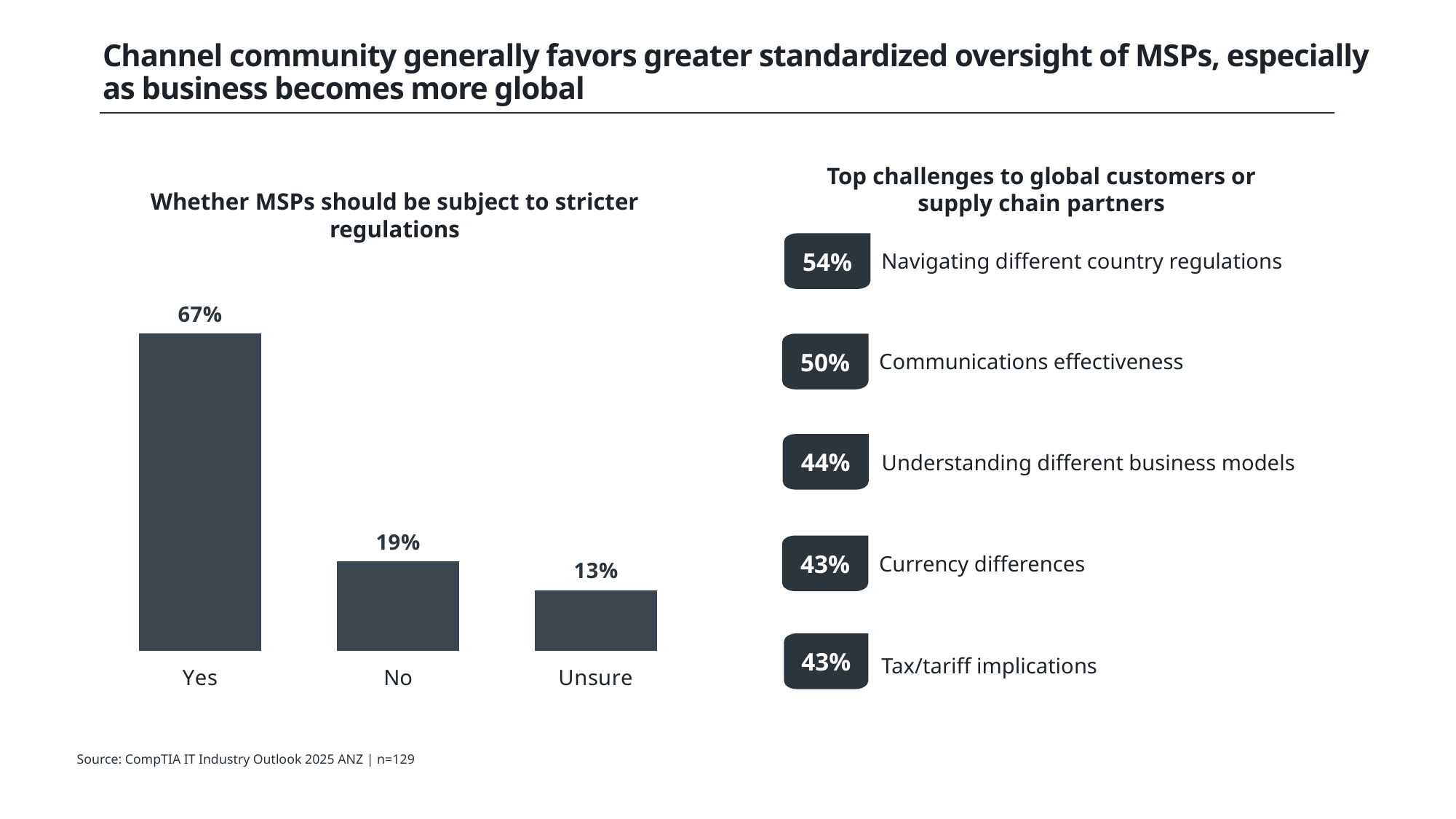
In the chart 'Whether MSPs should be subject to stricter regulations', what percentage answered No? 19% In the chart 'Whether MSPs should be subject to stricter regulations', which is larger, No or Unsure? No In 'Top challenges to global customers or supply chain partners', which challenge has the highest percentage? Navigating different country regulations In the chart 'Whether MSPs should be subject to stricter regulations', which response has the lowest value? Unsure In the chart 'Whether MSPs should be subject to stricter regulations', what percentage answered Unsure? 13% In the chart 'Whether MSPs should be subject to stricter regulations', do the values rise or fall from Yes to Unsure? Fall In 'Top challenges to global customers or supply chain partners', what percentage is shown for Navigating different country regulations? 54% In the chart 'Whether MSPs should be subject to stricter regulations', what percentage answered Yes? 67% In the chart 'Whether MSPs should be subject to stricter regulations', what is the difference between the Yes and No percentages? 48% How many response categories are shown in the chart 'Whether MSPs should be subject to stricter regulations'? 3 What type of chart is 'Whether MSPs should be subject to stricter regulations'? Bar chart In the chart 'Whether MSPs should be subject to stricter regulations', which response has the highest value? Yes